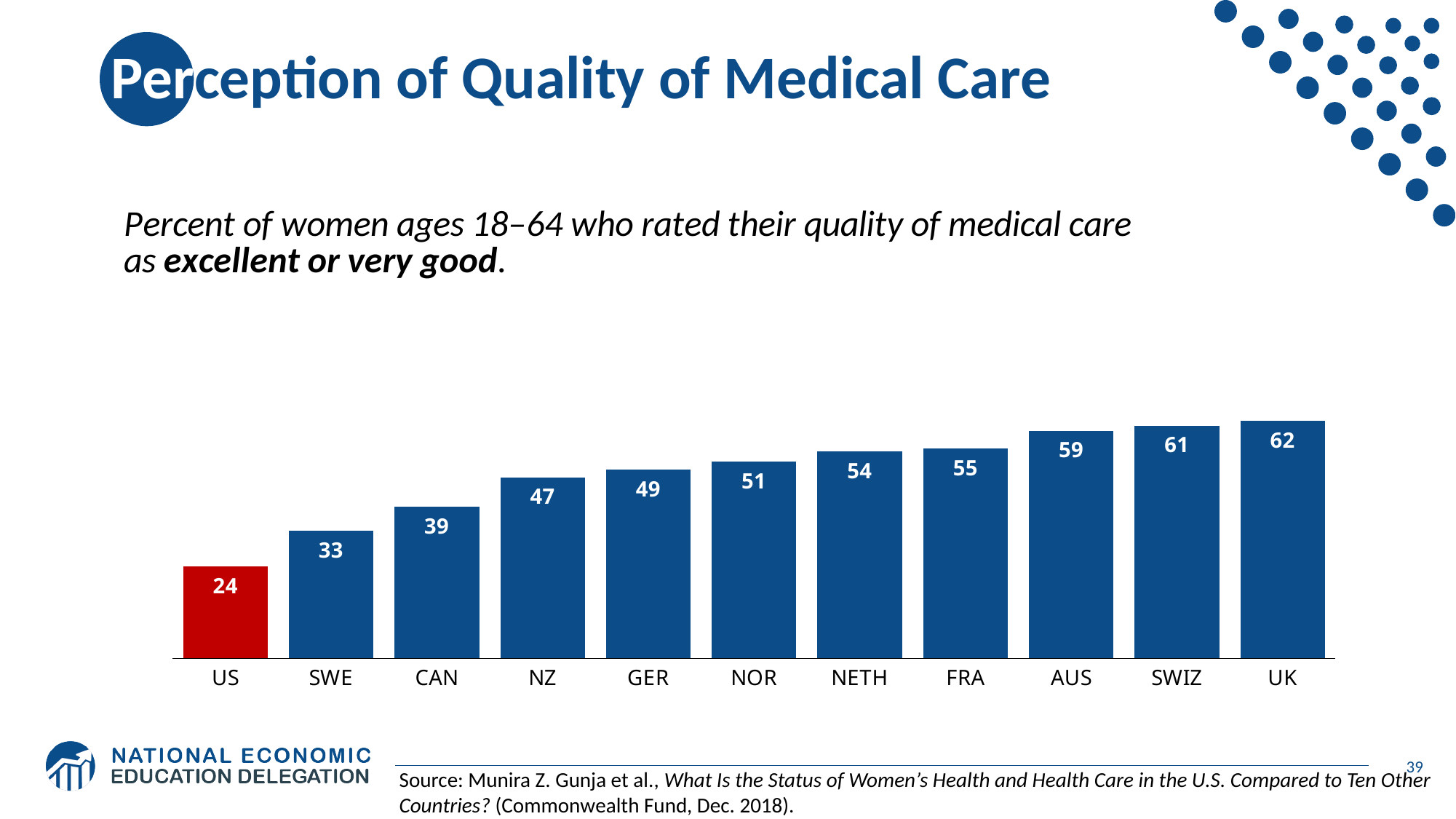
What is the value for AUS? 59 Which bar is coloured red rather than blue? US How many countries are shown in the chart? 11 What kind of chart is shown on the slide? bar chart What is the difference between the values for UK and US? 38 Do the values rise or fall from left to right across the x axis? rise Which is larger, the value for SWE or the value for NZ? NZ Which country has the lowest value? US What is the difference between the values for NETH and CAN? 15 What is the value for GER? 49 Which country has the highest value? UK What is the value for the US? 24